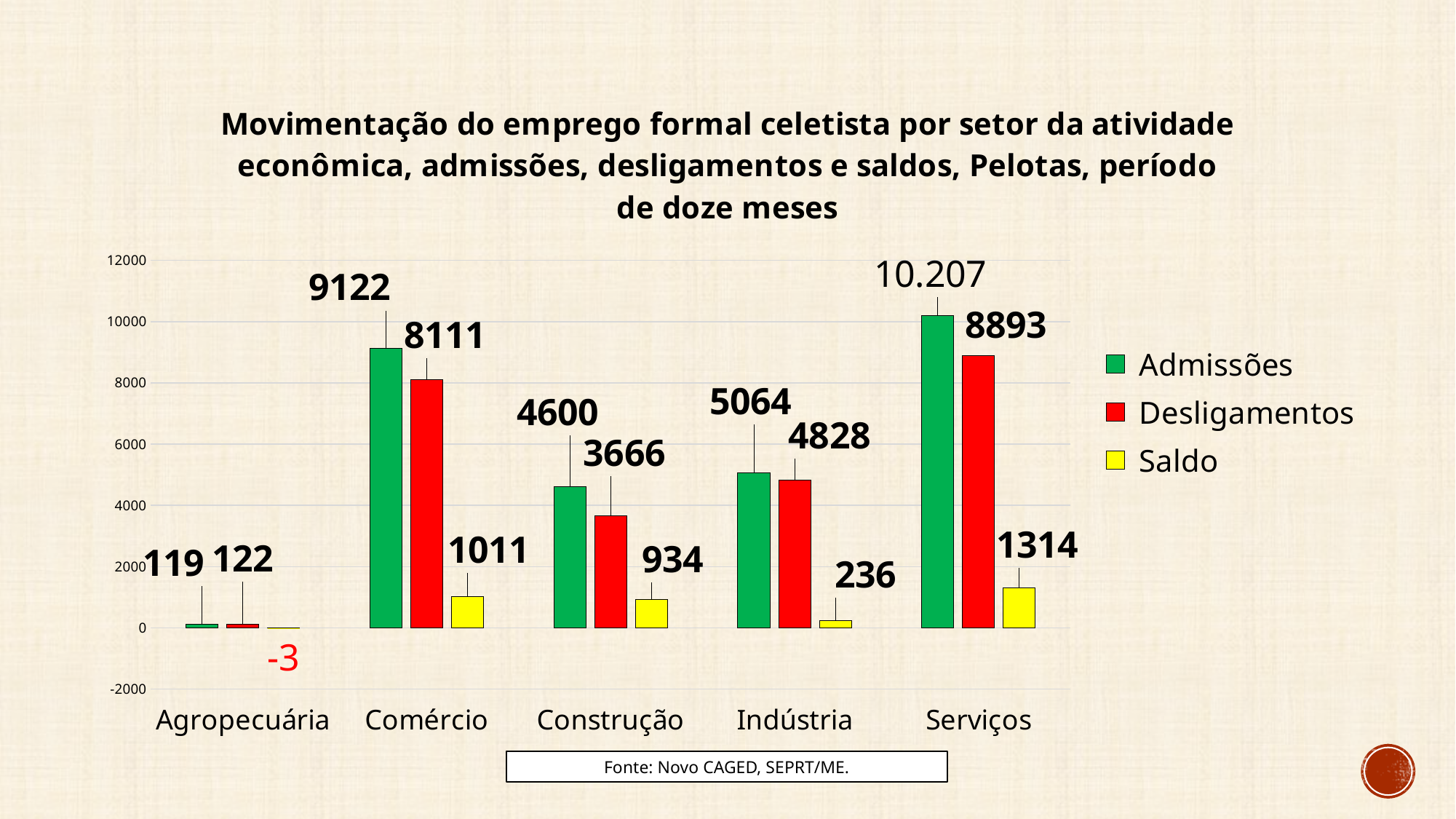
What is the difference between Admissões and Desligamentos for Construção? 934 How many series does the legend list? 3 How many sectors are shown on the x axis? 5 What kind of chart is shown on the slide? Bar chart What is the Saldo value for Agropecuária? -3 What colour represents the Saldo series in the legend? Yellow What is the Saldo value for Indústria? 236 Which sector has the highest Admissões value? Serviços Which sector has the lowest Desligamentos value? Agropecuária Which is larger for Indústria, Admissões or Desligamentos? Admissões What is the value of Admissões for Comércio? 9122 What is the value of Desligamentos for Serviços? 8893